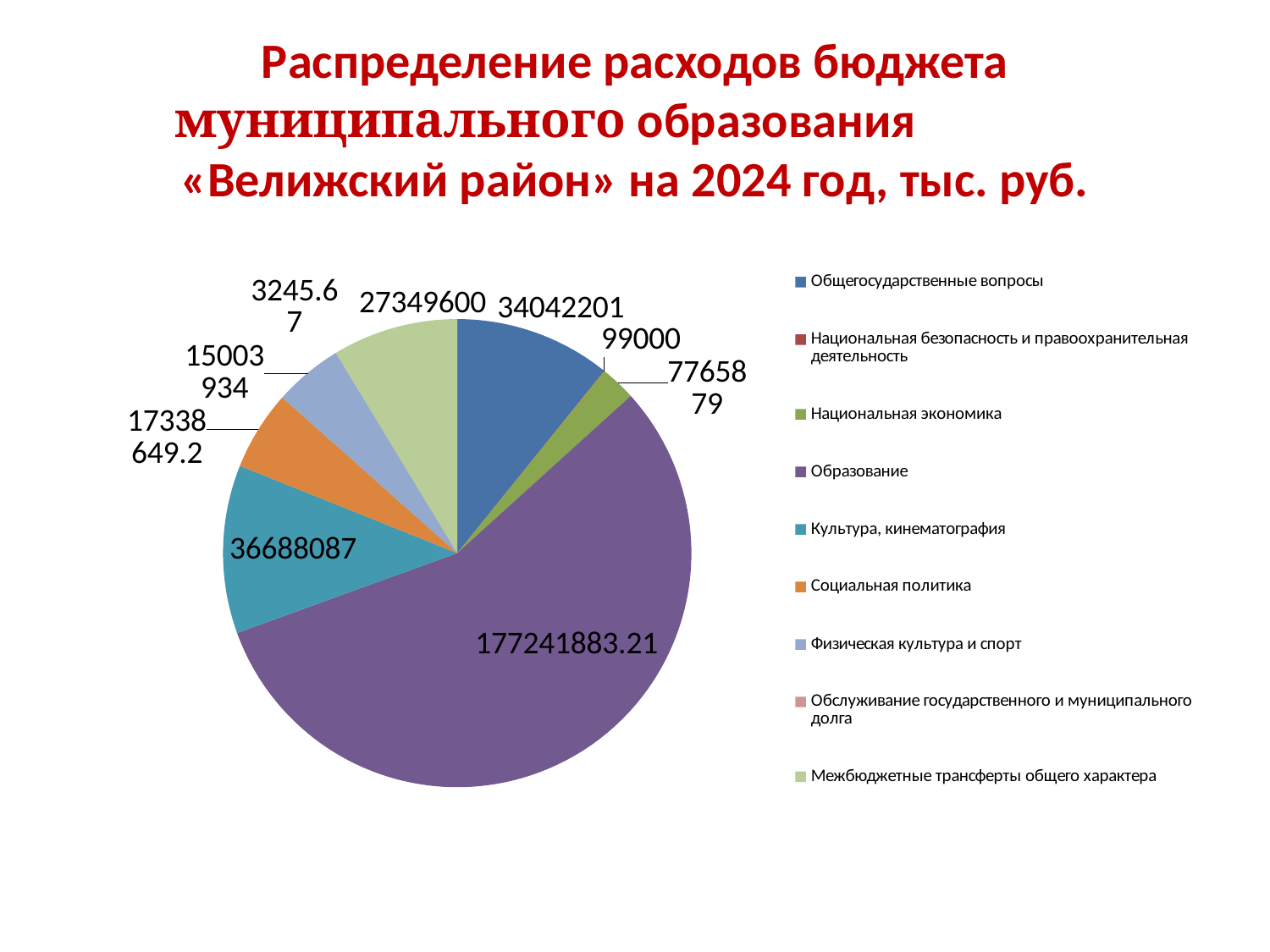
What is the value shown for Культура, кинематография? 36688087 Which category has the largest slice of the pie chart? Образование What kind of chart is shown on the slide? pie chart What is the value shown for Социальная политика? 17338649.2 What is the value shown for Национальная безопасность и правоохранительная деятельность? 99000 How many categories does the legend of the pie chart list? 9 What is the value shown for Межбюджетные трансферты общего характера? 27349600 What is the difference between the values for Культура, кинематография and Общегосударственные вопросы? 2645886 What is the value shown for Образование? 177241883.21 Which is larger: the value for Культура, кинематография or the value for Общегосударственные вопросы? Культура, кинематография What is the value shown for Общегосударственные вопросы? 34042201 Which category has the smallest value in the pie chart? Обслуживание государственного и муниципального долга